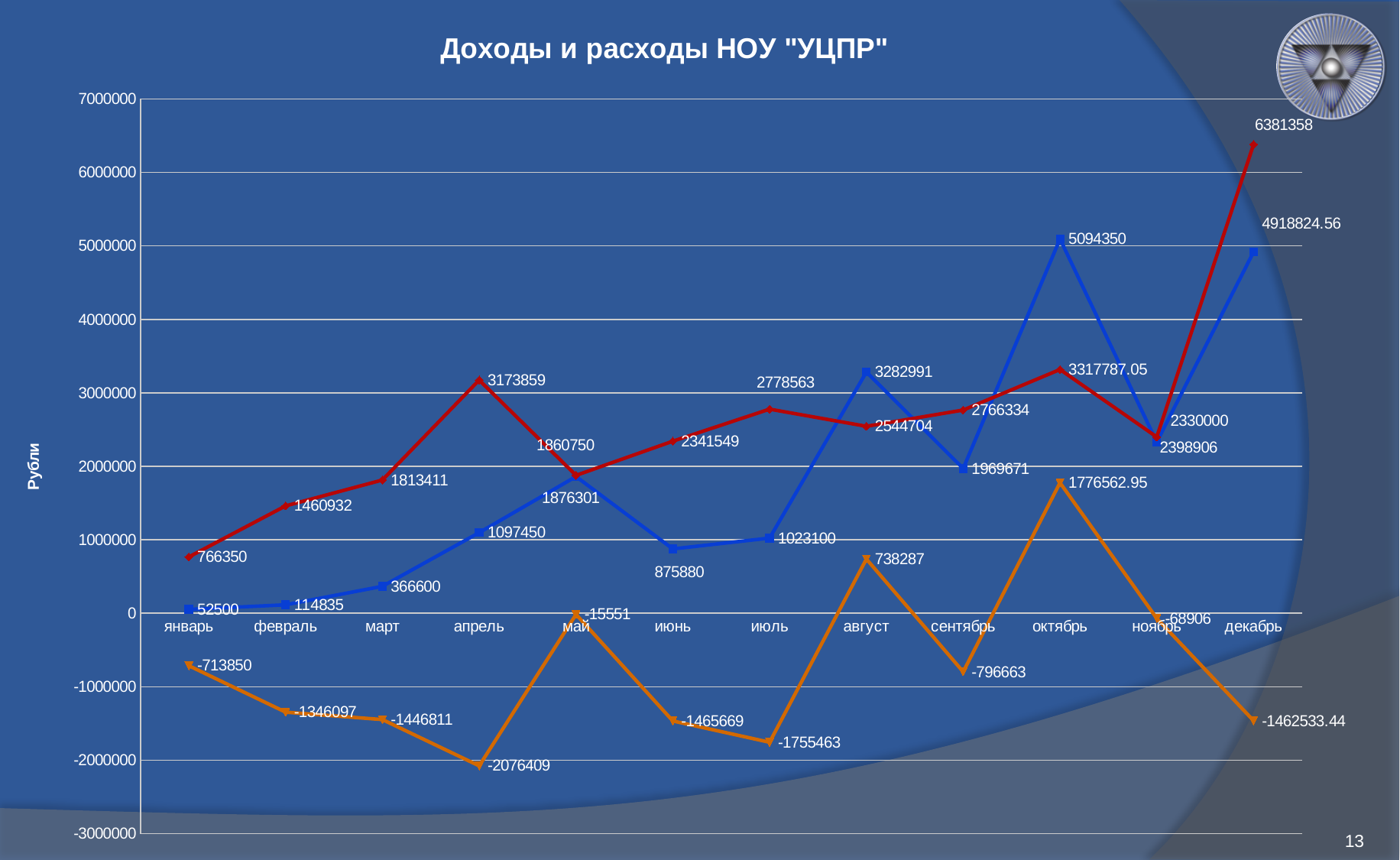
In which month does the red line reach its highest value? декабрь What label is shown on the vertical axis? Рубли What kind of chart is shown on the slide? line chart What is the difference between the red line and the blue line in декабрь? 1462533.44 How many lines (series) are plotted on the chart? 3 How many months are plotted along the x axis? 12 In which month does the orange line reach its lowest value? апрель What is the title of the chart? Доходы и расходы НОУ "УЦПР" In август, which is larger: the red line value or the blue line value? the blue line (3282991) What is the value of the red line for апрель? 3173859 What is the value of the orange line for сентябрь? -796663 What is the value of the blue line for октябрь? 5094350